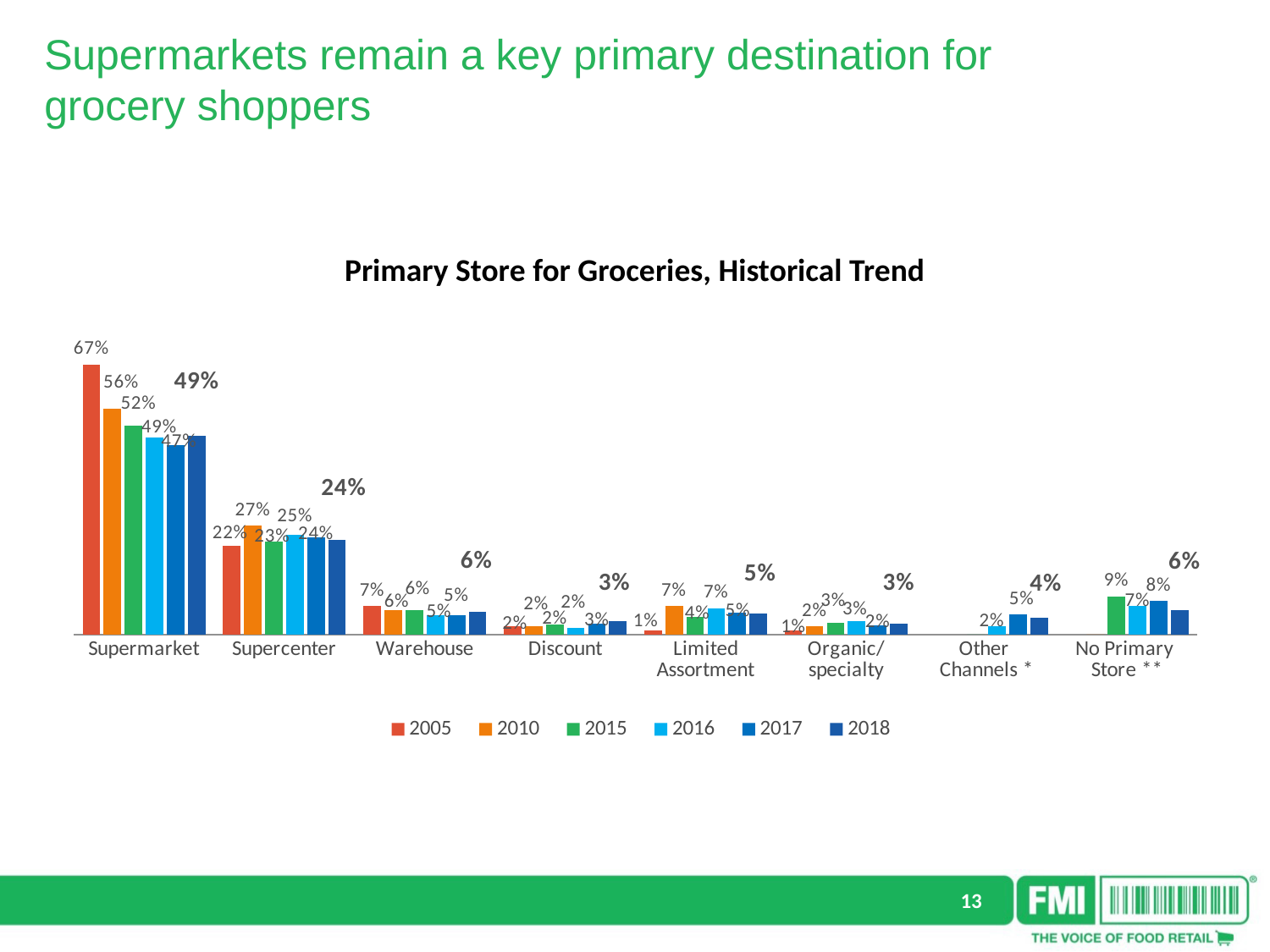
What is the value for Supercenter in 2018? 24% What is the title of the chart? Primary Store for Groceries, Historical Trend What is the value for Supermarket in 2018? 49% What kind of chart is shown on the slide? Bar chart What is the value for Supermarket in 2005? 67% What is the value for No Primary Store in 2015? 9% How many store categories are shown along the x axis? 8 For Supercenter, which year has the larger value, 2005 or 2010? 2010 Which category has the highest value in 2005? Supermarket How many series does the legend list? 6 Does the Supermarket value generally rise or fall from 2005 to 2018? Fall What is the difference between the Supermarket value in 2005 and in 2018? 18 percentage points